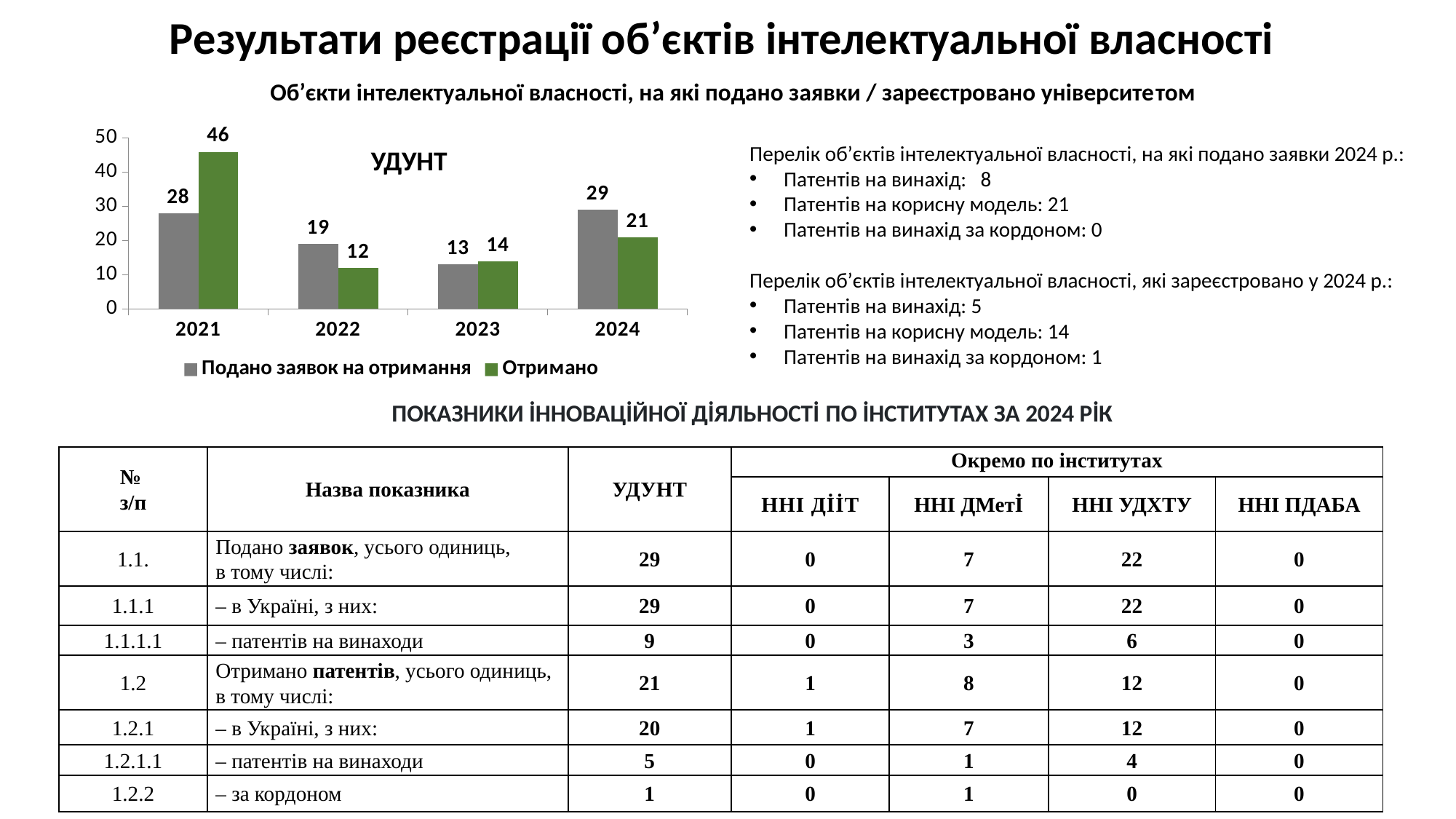
How many series does the chart legend list? 2 Is the "Отримано" value for 2021 greater or less than 40? greater In which year is the "Подано заявок на отримання" value lowest? 2023 Which is larger in 2024: "Подано заявок на отримання" or "Отримано"? Подано заявок на отримання What type of chart is shown on the slide? Bar chart In which year is the "Отримано" value highest? 2021 What is the title shown inside the chart? УДУНТ How many years are shown on the x axis of the chart? 4 What is the value of "Отримано" for 2022? 12 What is the difference between "Отримано" and "Подано заявок на отримання" in 2021? 18 What is the value of "Отримано" for 2024? 21 What is the value of "Подано заявок на отримання" for 2021? 28